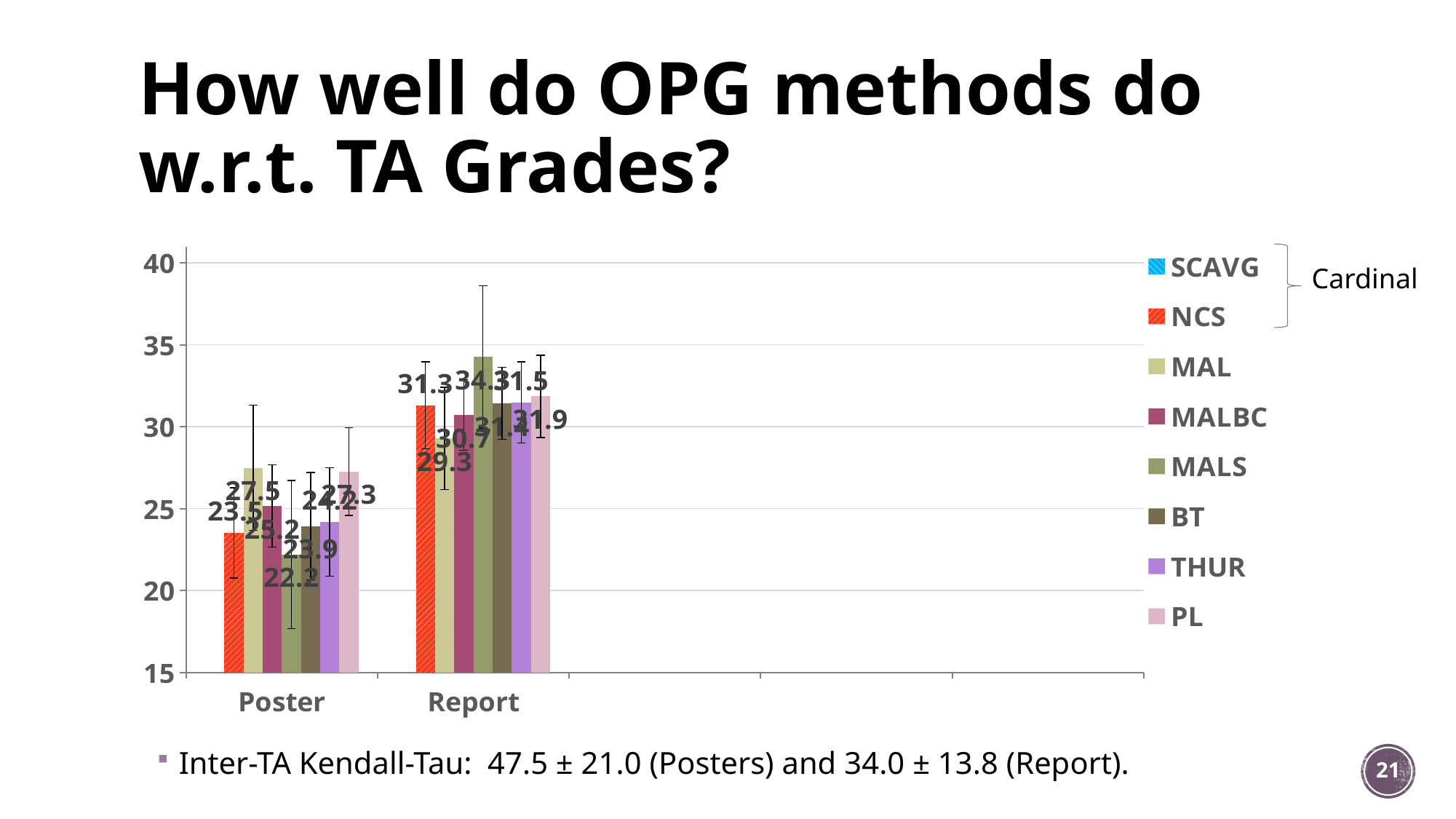
Which series has the highest value in the Report category? MALS Is the value for PL in the Report category greater or less than 30? greater What kind of chart is shown on the slide? bar chart Which series has the lowest value in the Poster category? MALS What is the value for NCS in the Report category? 31.3 How many series does the chart's legend list? 8 Which is larger for NCS: the Poster value or the Report value? Report Do the values generally rise or fall from Poster to Report? rise How many categories are shown on the x axis of the chart? 2 What is the value for NCS in the Poster category? 23.5 Is the value for BT in the Poster category greater or less than 25? less Which two legend entries are grouped under the label 'Cardinal'? SCAVG and NCS